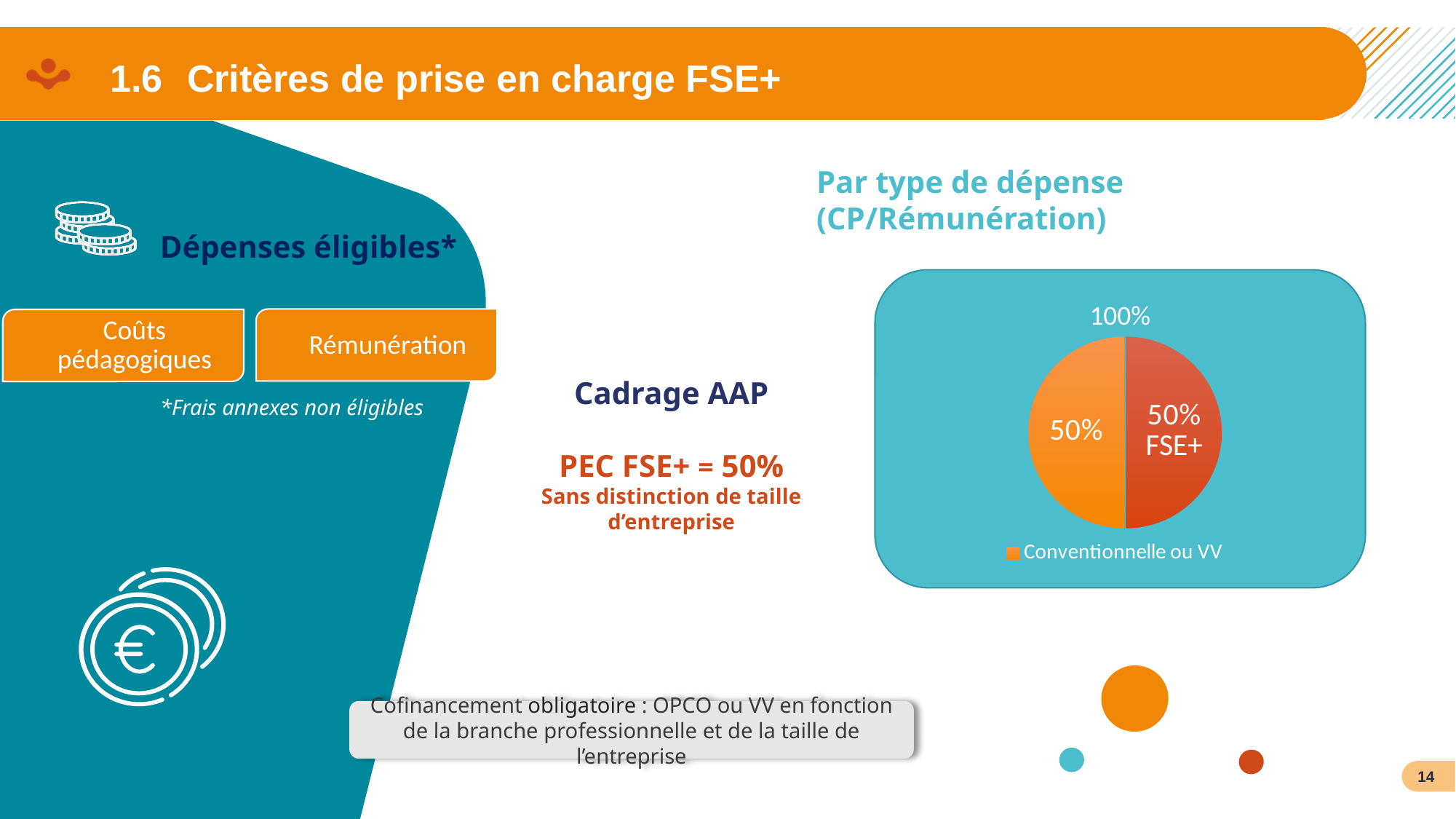
Is the FSE+ share of the pie chart greater or less than 40%? greater What kind of chart is shown on the slide? pie chart Which slice of the pie chart is coloured red-orange, FSE+ or Conventionnelle ou VV? FSE+ What is the difference between the FSE+ share and the Conventionnelle ou VV share in the pie chart? 0% What share of the pie chart does the orange slice (Conventionnelle ou VV) represent? 50% What percentage is printed above the pie chart? 100% How many entries does the legend below the pie chart list? 1 What share of the pie chart is labelled FSE+? 50% What legend entry is shown below the pie chart? Conventionnelle ou VV How many slices does the pie chart have? 2